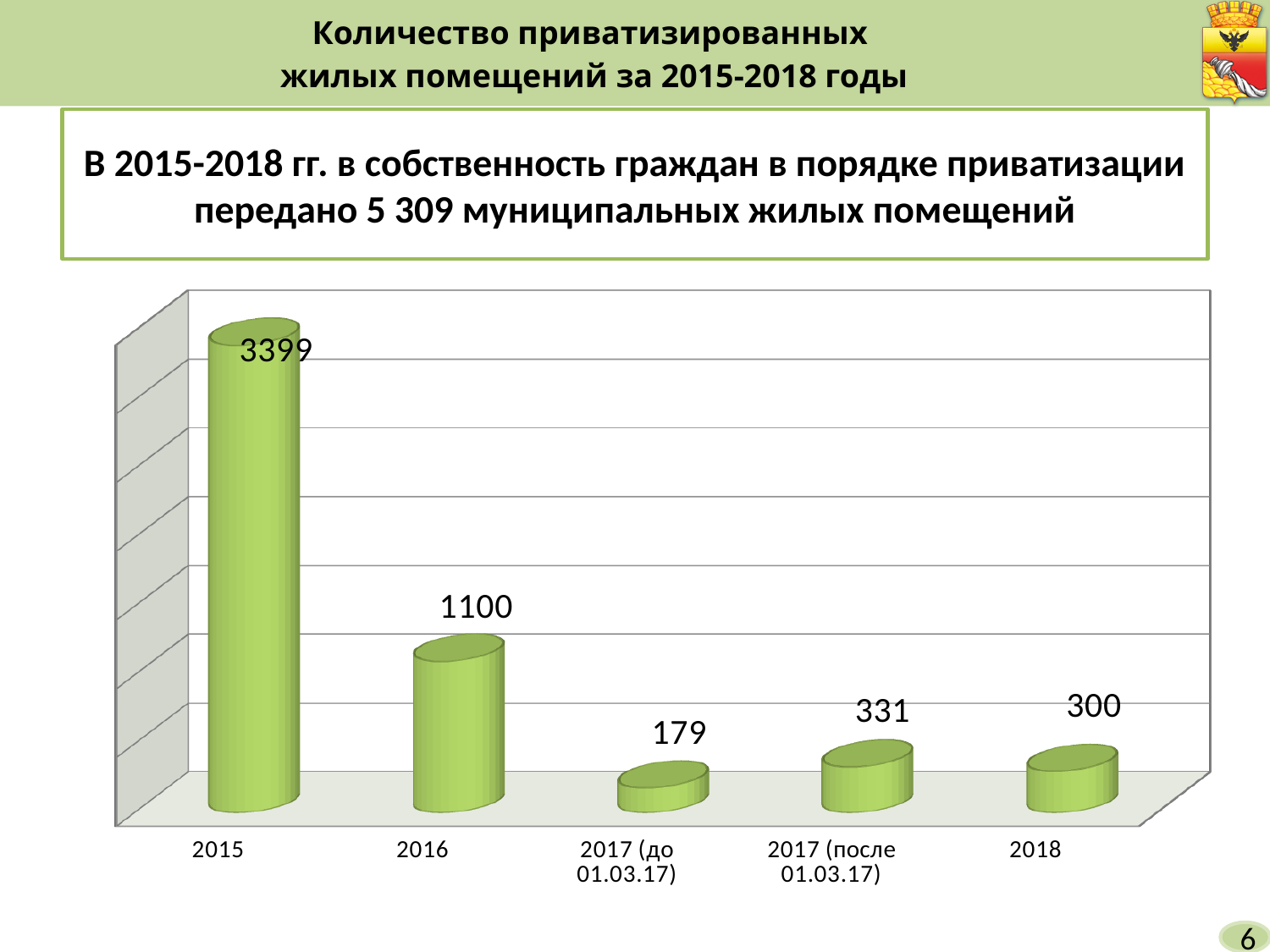
What is the value shown for 2017 (после 01.03.17)? 331 Which category has the highest value? 2015 What is the value shown for 2017 (до 01.03.17)? 179 Which is larger, the value for 2017 (после 01.03.17) or the value for 2018? 2017 (после 01.03.17) What kind of chart is shown on the slide? bar chart What is the number of privatized dwellings for 2015? 3399 How many categories are shown on the x axis? 5 What is the value shown for 2016? 1100 What is the difference between the values for 2015 and 2016? 2299 Which category has the lowest value? 2017 (до 01.03.17) Do the values rise or fall from 2015 to 2017 (до 01.03.17)? fall What is the value shown for 2018? 300